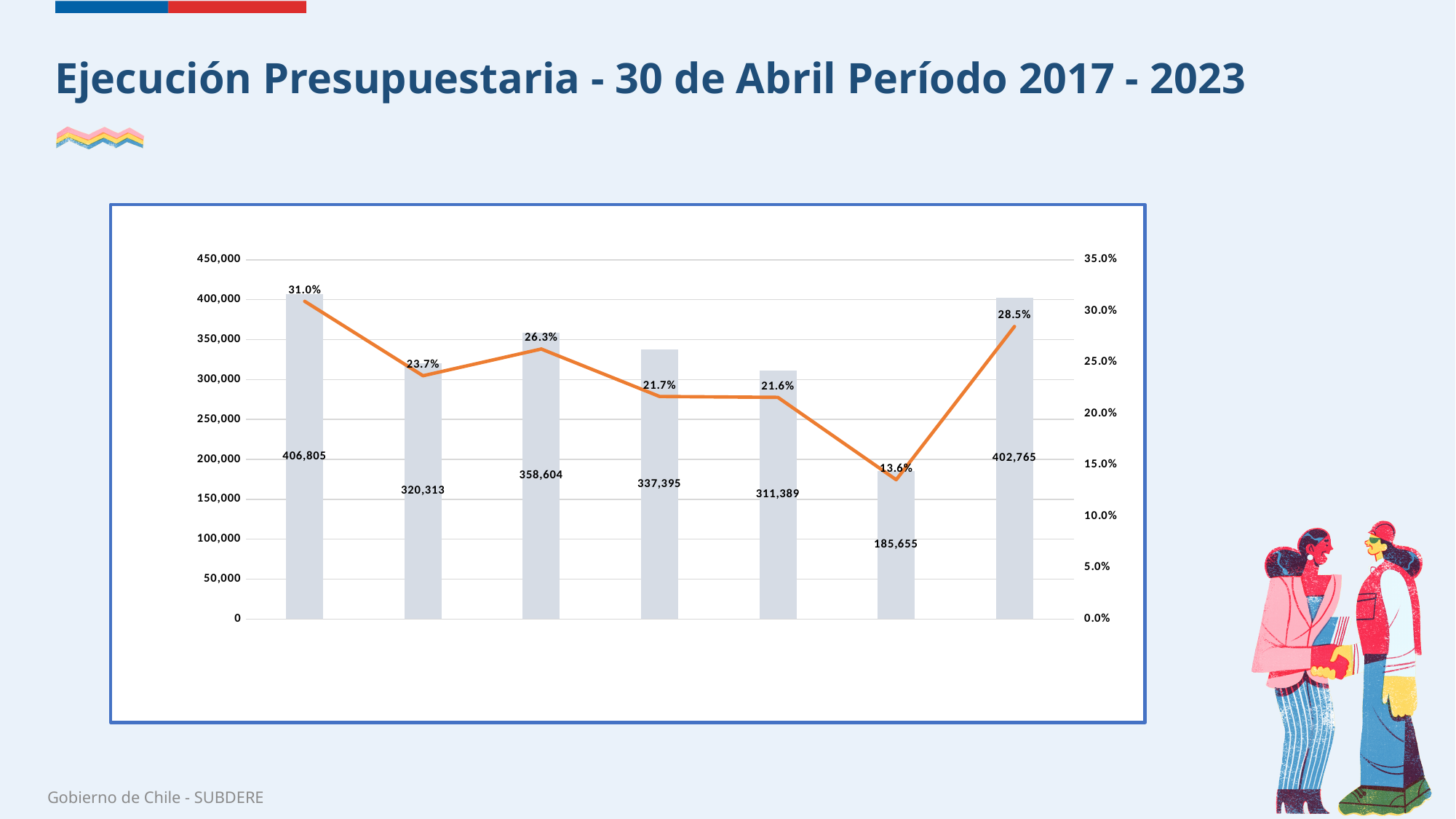
Which is larger, the third bar or the fourth bar? The third bar (358,604) What kind of chart is shown? A combined bar and line chart Is the value of the second bar greater or less than 300,000? greater What is the highest percentage shown on the orange line? 31.0% Which bar has the lowest value? The sixth bar (185,655) Which bar has the highest value? The first bar (406,805) What is the data label on the first (leftmost) bar? 406,805 What percentage is shown on the orange line at the sixth point from the left? 13.6% Does the orange line rise or fall from the first point to the sixth point? It falls What is the difference between the first bar (406,805) and the last bar (402,765)? 4,040 What is the data label on the last (rightmost) bar? 402,765 How many bars are plotted in the chart? 7